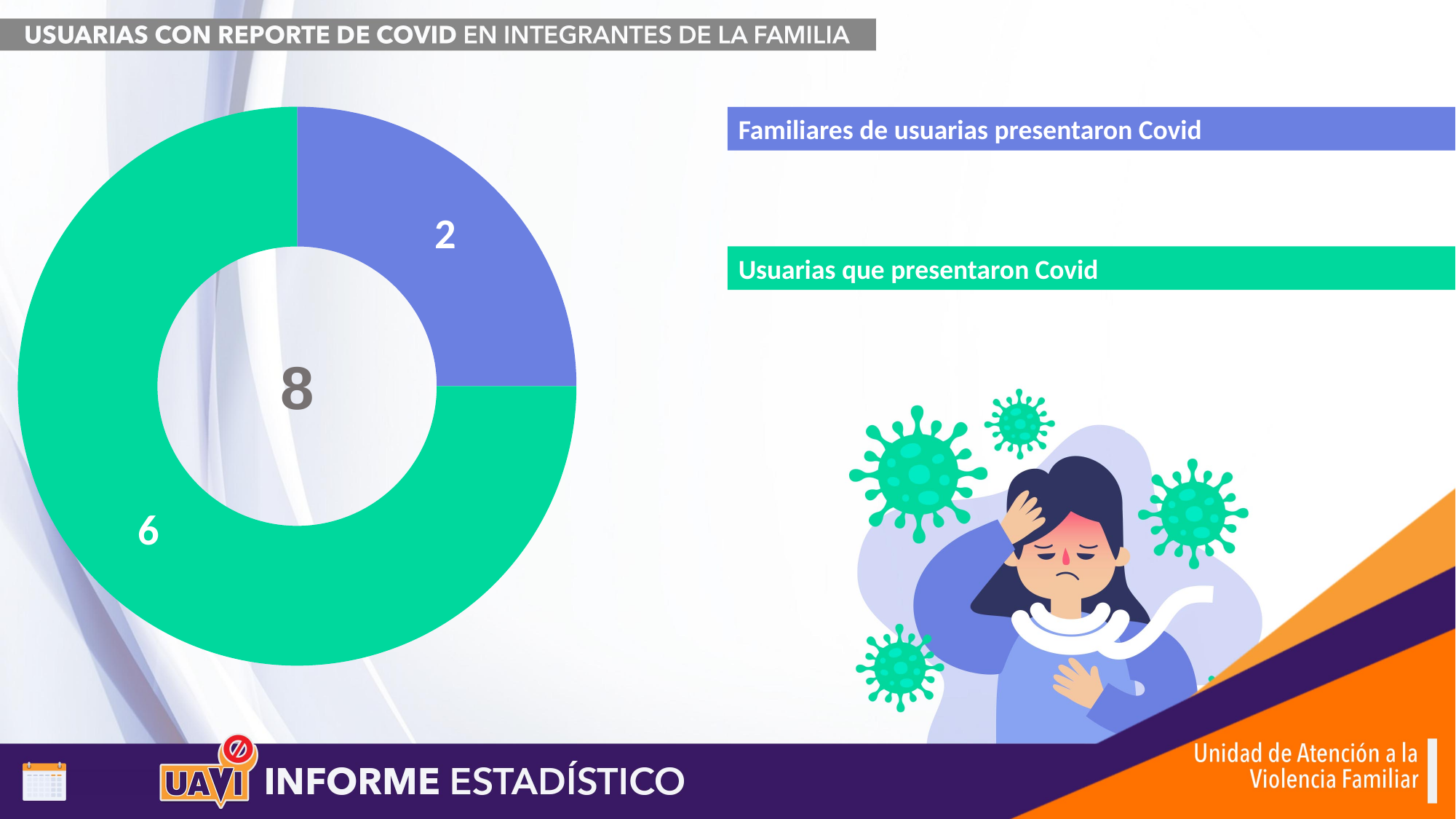
What is the difference between the values for "Usuarias que presentaron Covid" and "Familiares de usuarias presentaron Covid"? 4 What colour represents "Familiares de usuarias presentaron Covid" in the chart? Blue Which category has the smallest slice? Familiares de usuarias presentaron Covid What share of the total does "Familiares de usuarias presentaron Covid" represent? 25% Which is larger: "Usuarias que presentaron Covid" or "Familiares de usuarias presentaron Covid"? Usuarias que presentaron Covid How many categories does the chart show? 2 What kind of chart is shown on the slide? Doughnut chart What is the total shown in the centre of the doughnut chart? 8 What is the value for "Usuarias que presentaron Covid"? 6 Which category has the largest slice? Usuarias que presentaron Covid What share of the total does "Usuarias que presentaron Covid" represent? 75% What is the value for "Familiares de usuarias presentaron Covid"? 2